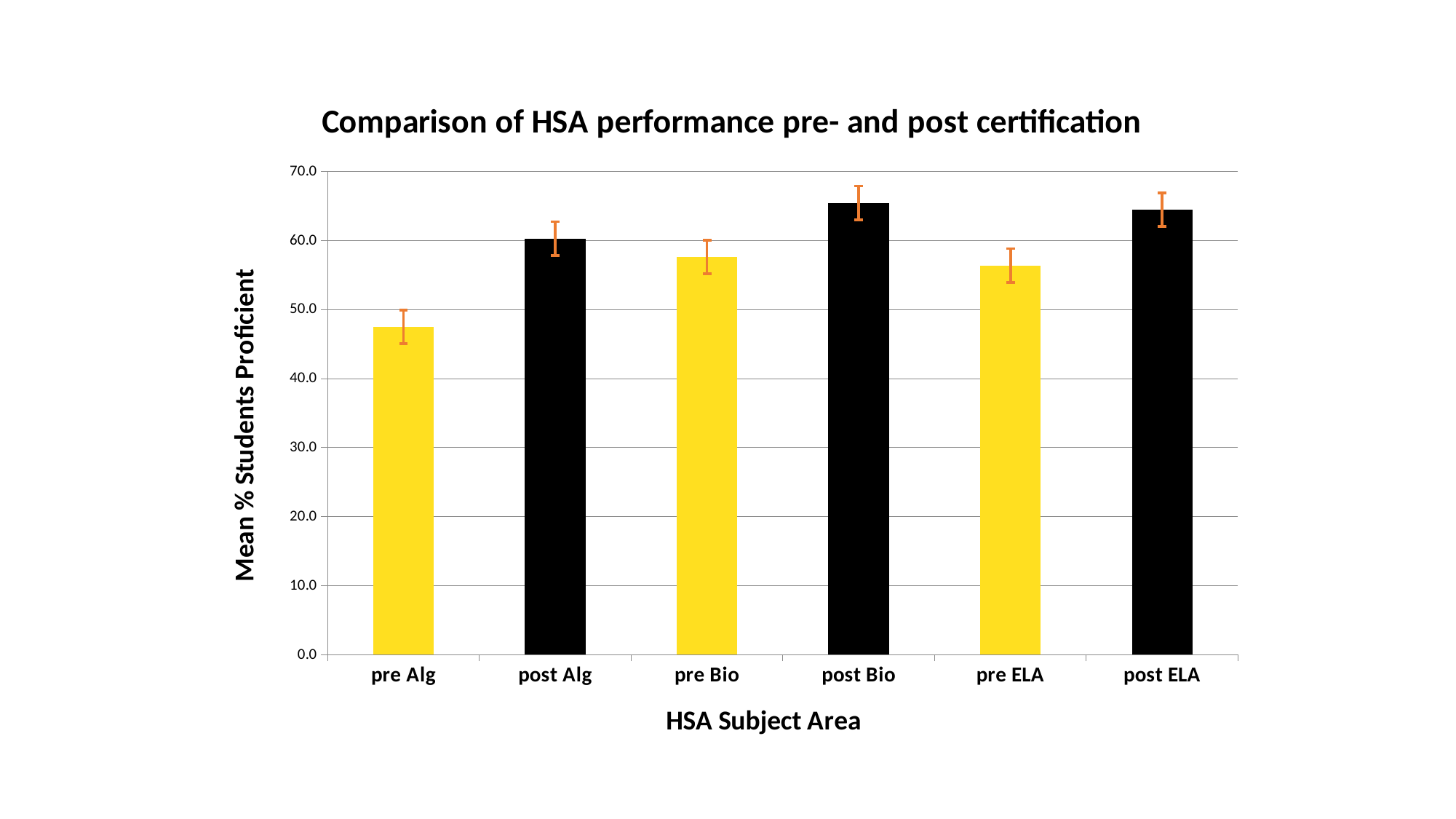
Which category has the lowest mean % students proficient? pre Alg Is the value for pre Alg greater or less than 50.0? less Is the value for pre ELA greater or less than 50.0? greater Is the value for pre Bio greater or less than 60.0? less Which is larger, the value for pre ELA or the value for post ELA? post ELA What kind of chart is shown on the slide? bar chart What is the label of the y axis? Mean % Students Proficient How many bars (categories) are plotted on the chart? 6 Which is larger, the value for pre Alg or the value for post Alg? post Alg What is the title of the chart? Comparison of HSA performance pre- and post certification Which is larger, the value for pre Bio or the value for post Bio? post Bio